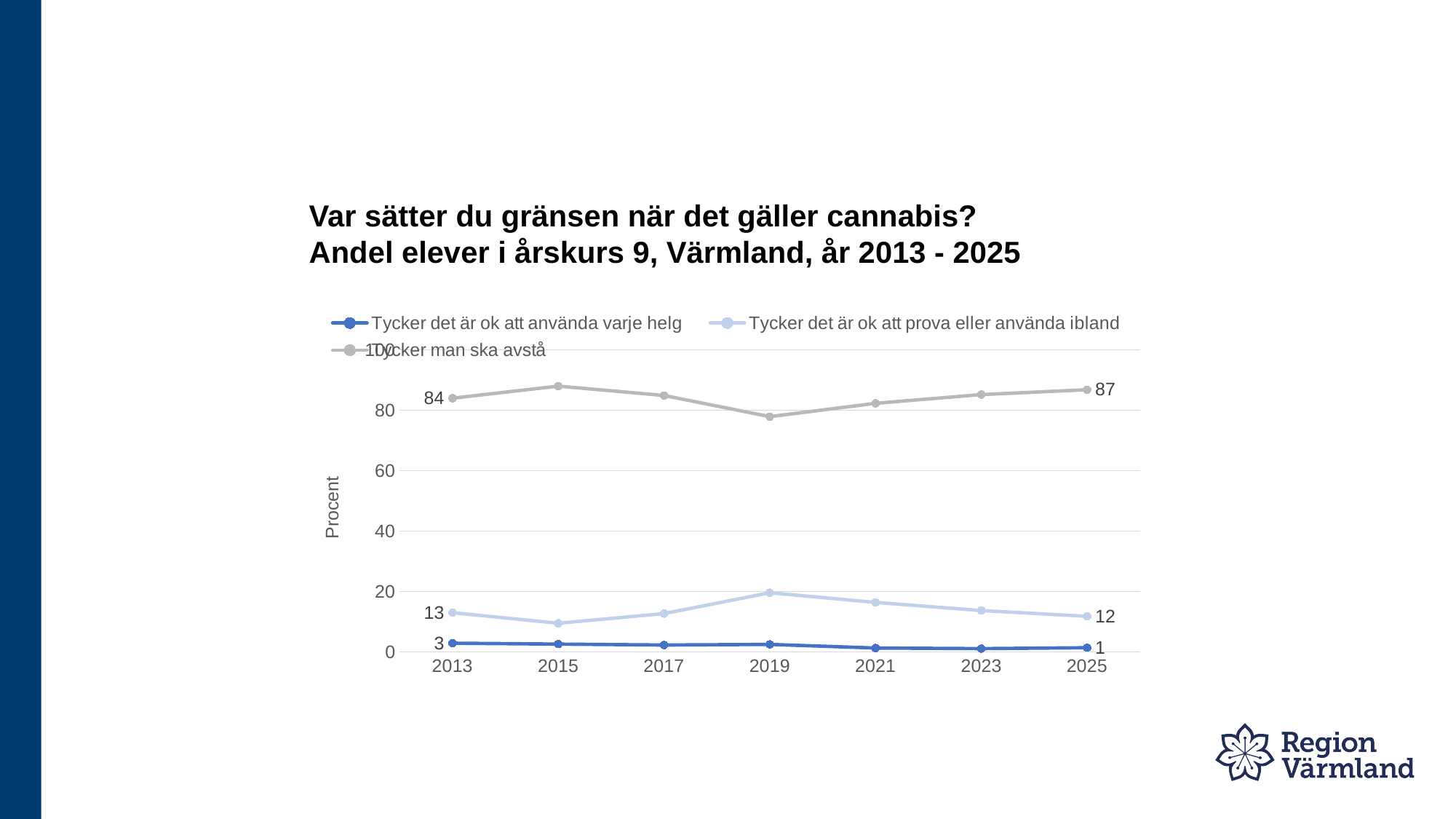
What is the value for "Tycker man ska avstå" in 2025? 87 What is the difference between "Tycker det är ok att prova eller använda ibland" and "Tycker det är ok att använda varje helg" in 2013? 10 What is the value for "Tycker det är ok att använda varje helg" in 2025? 1 By how much did "Tycker man ska avstå" change from 2013 to 2025? 3 What kind of chart is shown on the slide? line chart How many years are shown on the x axis? 7 What is the value for "Tycker man ska avstå" in 2013? 84 How many series does the legend list? 3 Is the value for "Tycker man ska avstå" in 2019 greater or less than 80? less What is the label of the y axis? Procent What is the value for "Tycker det är ok att prova eller använda ibland" in 2013? 13 Which series has the highest value in 2025? Tycker man ska avstå